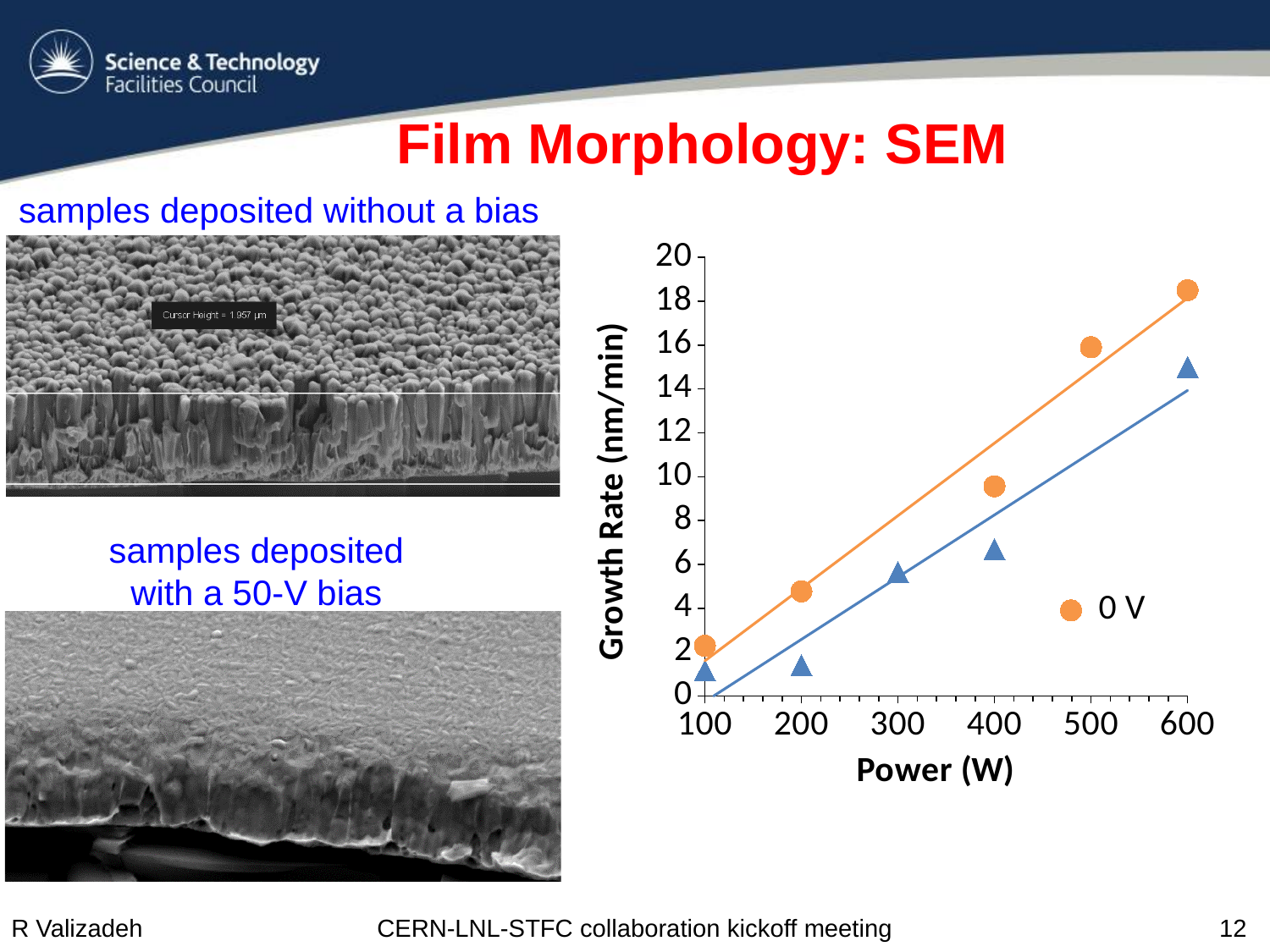
Does the growth rate for the 0 V series rise or fall as power increases from 100 W to 600 W? rise What is the label of the y axis of the chart? Growth Rate (nm/min) What is the label of the x axis of the chart? Power (W) Is the growth rate for the 0 V series at 600 W greater or less than 16? greater Is the growth rate for the 0 V series at 200 W greater or less than 6? less How many data points does the 0 V (orange circle) series have? 5 At 600 W, which series has the higher growth rate, the 0 V orange circles or the blue triangles? 0 V Is the growth rate for the blue triangle series at 200 W greater or less than 2? less What kind of chart is shown on the slide? scatter chart How many series entries does the chart's legend list? 1 At which power does the 0 V series reach its highest growth rate? 600 At which power does the 0 V series have its lowest growth rate? 100